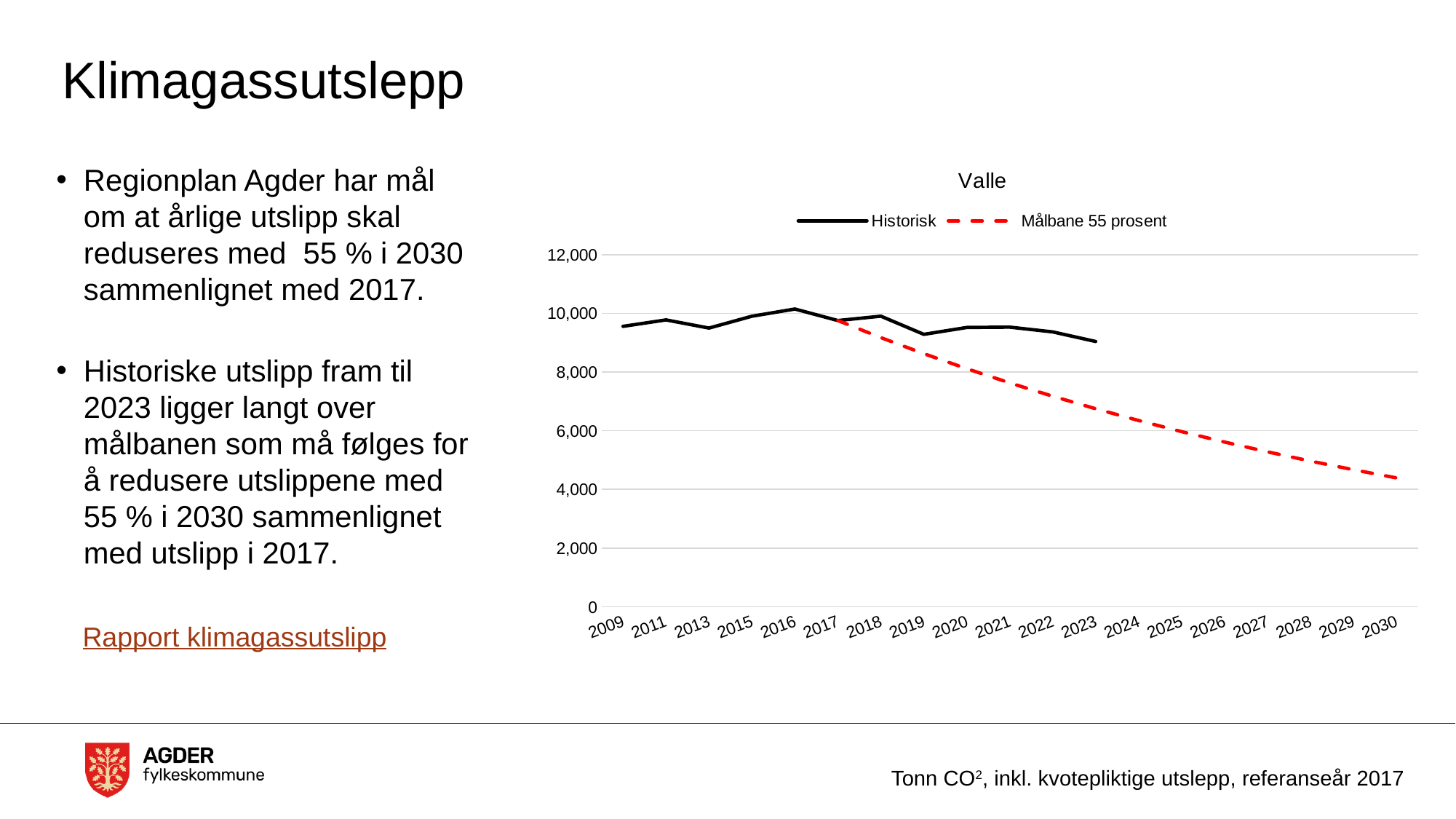
Does the Målbane 55 prosent line rise or fall from 2017 to 2030? fall What kind of chart is shown on the slide? line chart Is the Målbane 55 prosent value for 2030 greater or less than 6,000? less How many year labels are shown on the x axis? 19 Is the Målbane 55 prosent value for 2025 greater or less than 8,000? less How many series does the chart legend list? 2 Is the Historisk value for 2016 greater or less than 10,000? greater In 2023, which series has the larger value, Historisk or Målbane 55 prosent? Historisk Which series is drawn as a red dashed line? Målbane 55 prosent What is the title of the chart? Valle